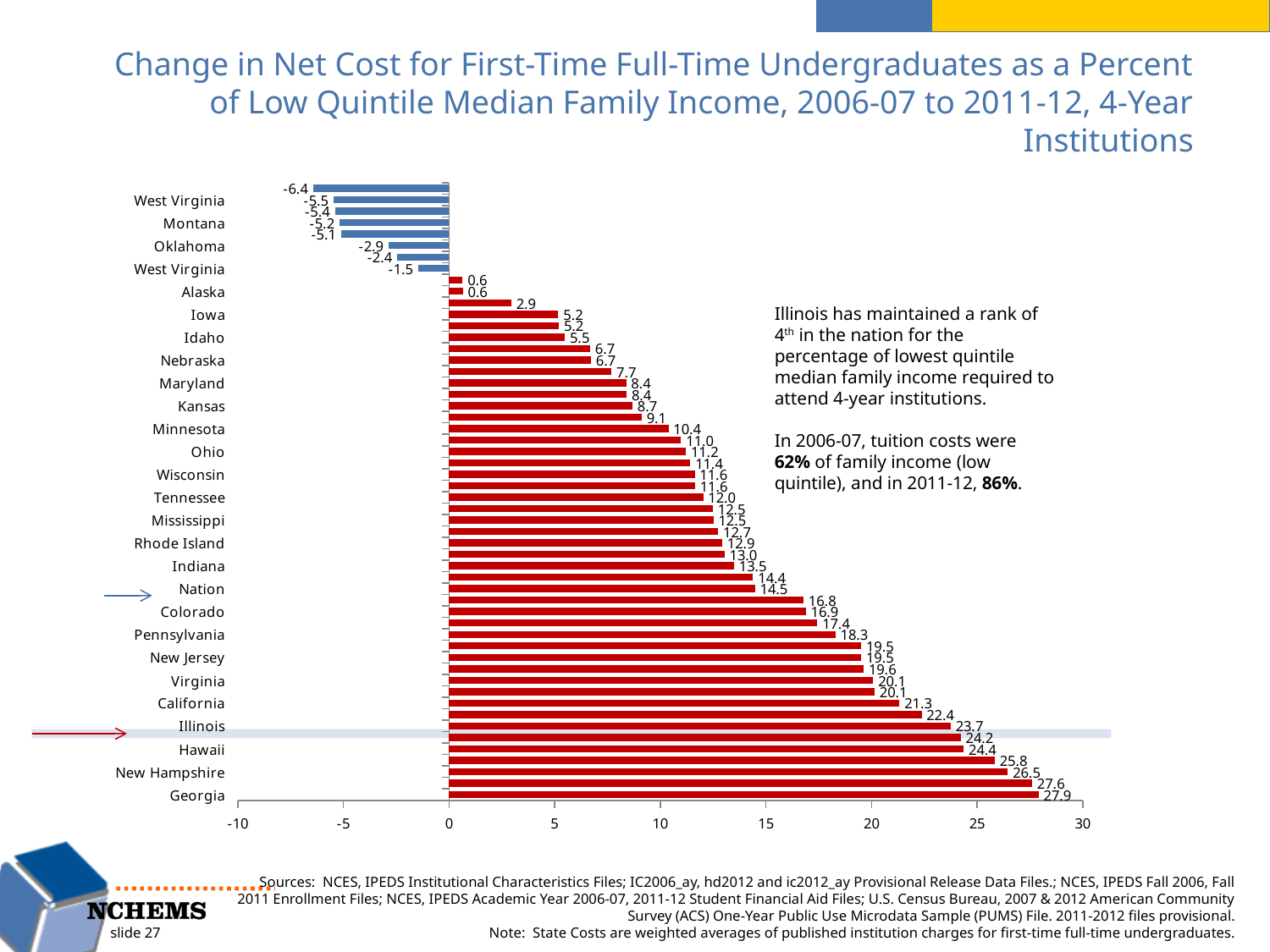
What kind of chart is shown on the slide? bar chart Which labeled category has the highest value? Georgia What is the value for New Hampshire? 26.5 What colour are the bars with negative values? blue What is the value for Georgia? 27.9 What is the value for the Nation? 14.5 Is the value for Georgia greater or less than 25? greater What is the value for Alaska? 0.6 What is the value for Illinois? 23.7 Which is larger, the value for Illinois or the value for the Nation? Illinois What is the lowest value shown on the chart? -6.4 What is the difference between the values for Georgia and Illinois? 4.2